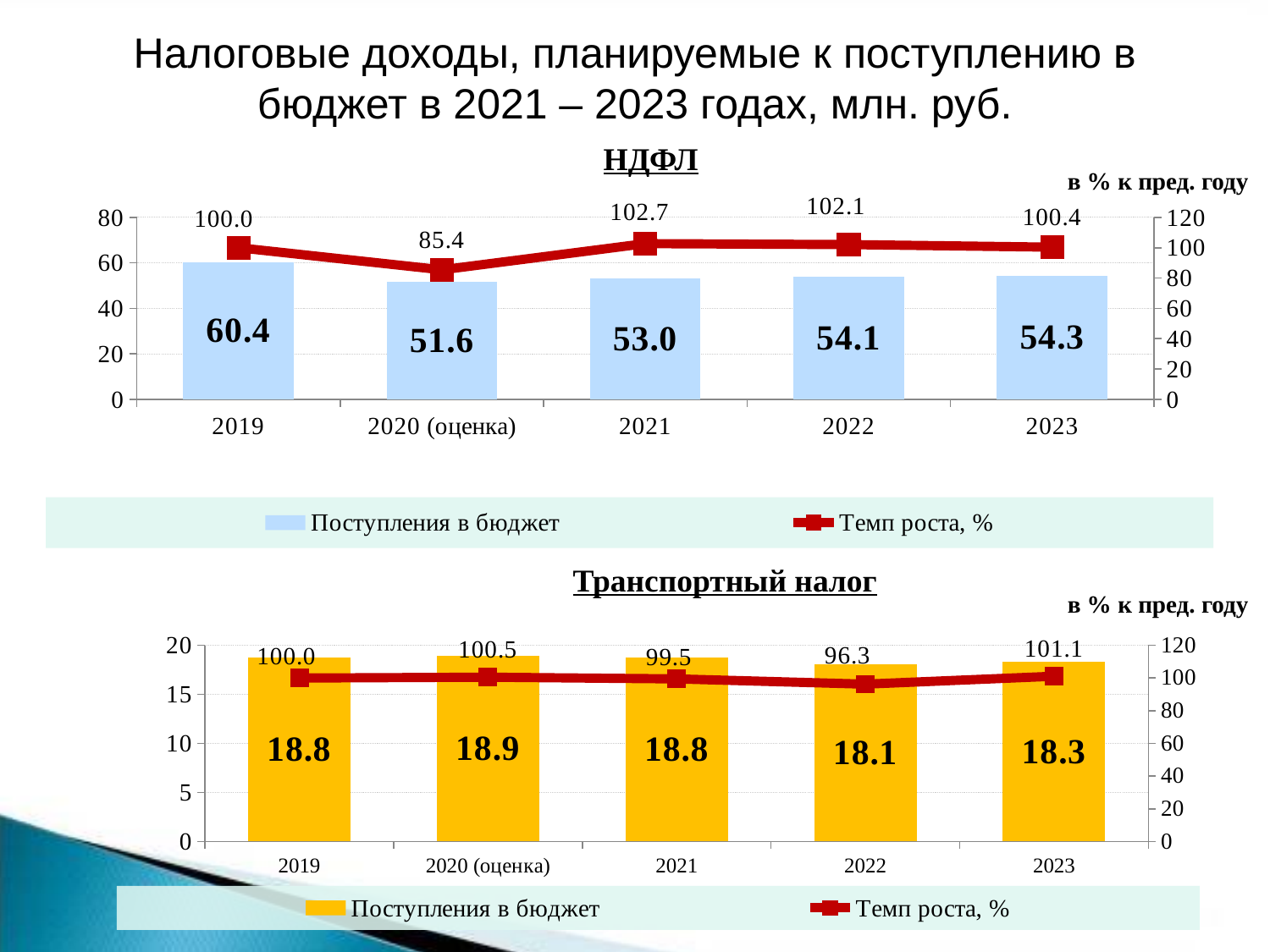
In the Транспортный налог chart, what is the Темп роста, % value for 2023? 101.1 In the Транспортный налог chart, which year has the highest Поступления в бюджет value? 2020 (оценка) In the НДФЛ chart, what is the value of Поступления в бюджет for 2019? 60.4 In the Транспортный налог chart, what is the value of Поступления в бюджет for 2022? 18.1 In the НДФЛ chart, what is the Темп роста, % value for 2021? 102.7 In the НДФЛ chart, how many series does the legend list? 2 In the НДФЛ chart, which year has the lowest Поступления в бюджет value? 2020 (оценка) In the Транспортный налог chart, which year has the lowest Темп роста, % value? 2022 What colour are the Поступления в бюджет bars in the Транспортный налог chart? Yellow In the НДФЛ chart, is the Темп роста, % value for 2022 larger or smaller than the value for 2023? larger In the Транспортный налог chart, how many years are shown on the x axis? 5 In the НДФЛ chart, what is the difference between the Поступления в бюджет values for 2019 and 2020 (оценка)? 8.8